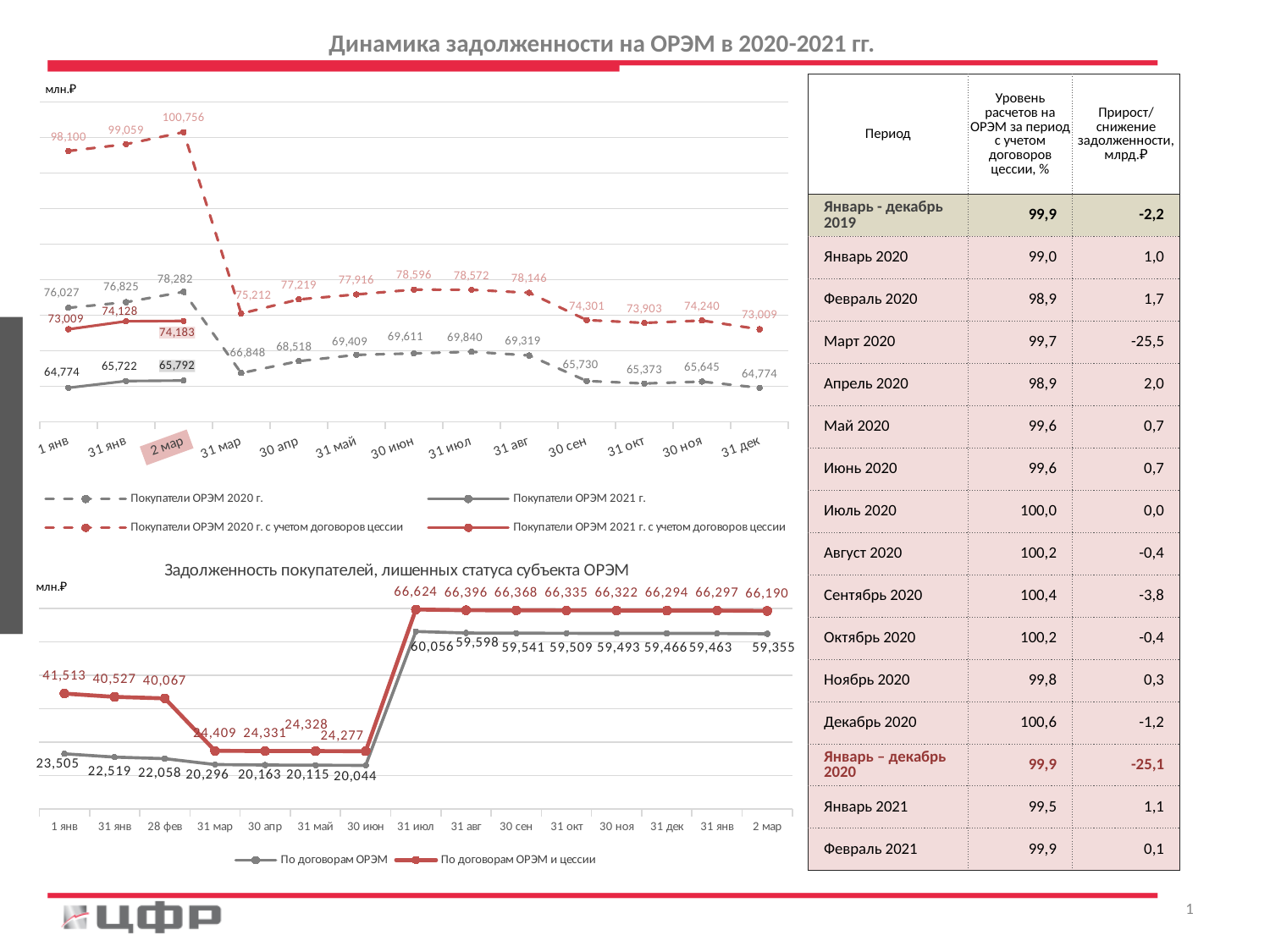
In the top chart 'Динамика задолженности на ОРЭМ в 2020-2021 гг.', at which date is the 'Покупатели ОРЭМ 2020 г.' series highest? 2 мар In the top chart 'Динамика задолженности на ОРЭМ в 2020-2021 гг.', what is the value for 'Покупатели ОРЭМ 2020 г. с учетом договоров цессии' on 2 мар? 100,756 In the bottom chart 'Задолженность покупателей, лишенных статуса субъекта ОРЭМ', what is the value for 'По договорам ОРЭМ' on 2 мар? 59,355 What kind of chart is the bottom chart 'Задолженность покупателей, лишенных статуса субъекта ОРЭМ'? Line chart In the top chart 'Динамика задолженности на ОРЭМ в 2020-2021 гг.', what is the value for 'Покупатели ОРЭМ 2021 г. с учетом договоров цессии' on 31 янв? 74,128 In the top chart 'Динамика задолженности на ОРЭМ в 2020-2021 гг.', what is the difference between the 'Покупатели ОРЭМ 2020 г. с учетом договоров цессии' values on 2 мар and 31 мар? 25,544 In the top chart 'Динамика задолженности на ОРЭМ в 2020-2021 гг.', what is the value for 'Покупатели ОРЭМ 2020 г.' on 31 июл? 69,840 In the bottom chart 'Задолженность покупателей, лишенных статуса субъекта ОРЭМ', what is the value for 'По договорам ОРЭМ и цессии' on 31 июл? 66,624 In the bottom chart 'Задолженность покупателей, лишенных статуса субъекта ОРЭМ', which is larger on 1 янв: 'По договорам ОРЭМ' or 'По договорам ОРЭМ и цессии'? По договорам ОРЭМ и цессии How many series does the legend of the top chart 'Динамика задолженности на ОРЭМ в 2020-2021 гг.' list? 4 In the top chart 'Динамика задолженности на ОРЭМ в 2020-2021 гг.', at which date is the 'Покупатели ОРЭМ 2020 г. с учетом договоров цессии' series lowest? 31 дек In the bottom chart 'Задолженность покупателей, лишенных статуса субъекта ОРЭМ', how many dates are shown on the x axis? 15